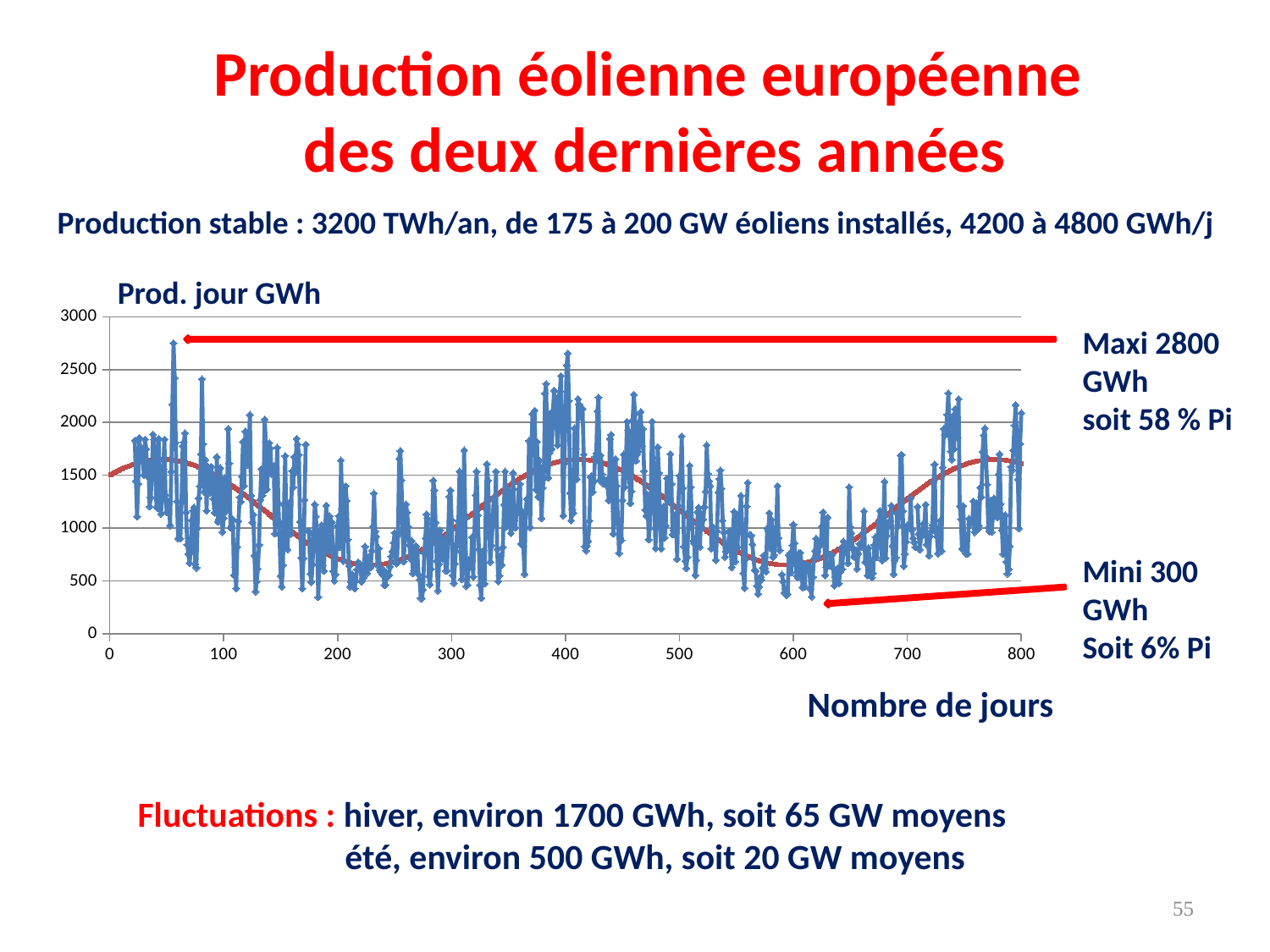
What is the label of the horizontal axis of the chart? Nombre de jours According to the annotation on the chart, what is the minimum daily production? 300 GWh Is the peak daily production around day 400 greater or less than 2500 GWh? greater What is the highest tick value shown on the horizontal axis? 800 According to the annotation on the chart, what is the maximum daily production? 2800 GWh Does the smoothed trend of daily production rise or fall between day 0 and day 200? fall What is the highest tick value shown on the vertical axis? 3000 What percentage of installed power (Pi) does the annotated minimum of 300 GWh correspond to? 6% Pi What percentage of installed power (Pi) does the annotated maximum of 2800 GWh correspond to? 58 % Pi What is the label of the vertical axis of the chart? Prod. jour GWh What kind of chart is shown on the slide? line chart